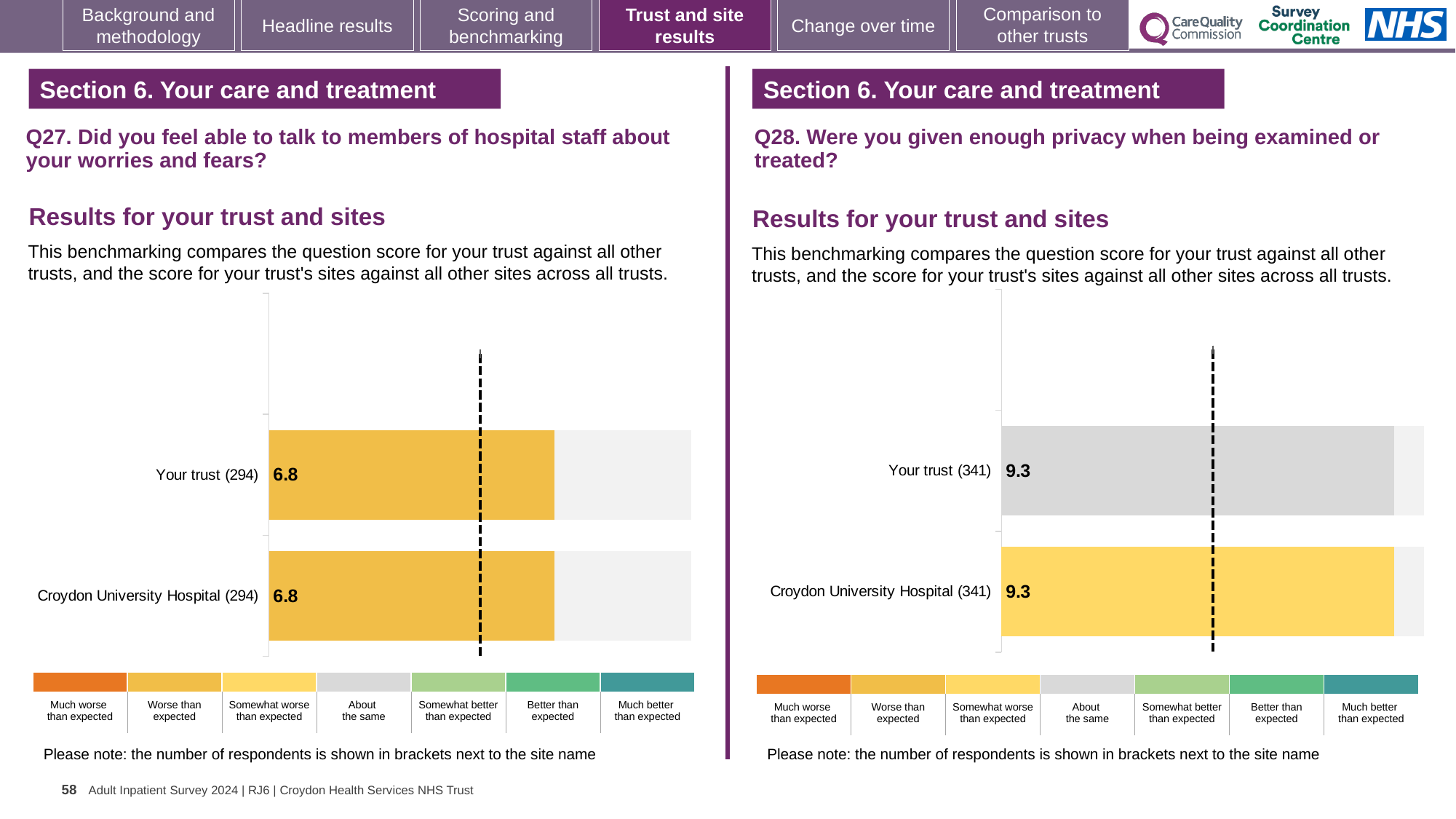
Is the Your trust score in the Q28 chart on the right larger or smaller than the Your trust score in the Q27 chart on the left? Larger In the Q28 chart on the right, what is the score for Your trust? 9.3 In the Q28 chart on the right, what is the difference between the Your trust score and the Croydon University Hospital score? 0 What kind of chart is used for the Q27 results on the left? Bar chart In the Q28 chart on the right, how many respondents are shown in brackets for Croydon University Hospital? 341 How many bars are plotted in the Q27 chart on the left? 2 In the Q28 chart on the right, what is the score for Croydon University Hospital? 9.3 In the Q27 chart on the left, what is the score for Croydon University Hospital? 6.8 In the Q27 chart on the left, what is the score for Your trust? 6.8 How many bars are plotted in the Q28 chart on the right? 2 In the Q27 chart on the left, how many respondents are shown in brackets for Your trust? 294 In the Q27 chart on the left, what is the difference between the Your trust score and the Croydon University Hospital score? 0